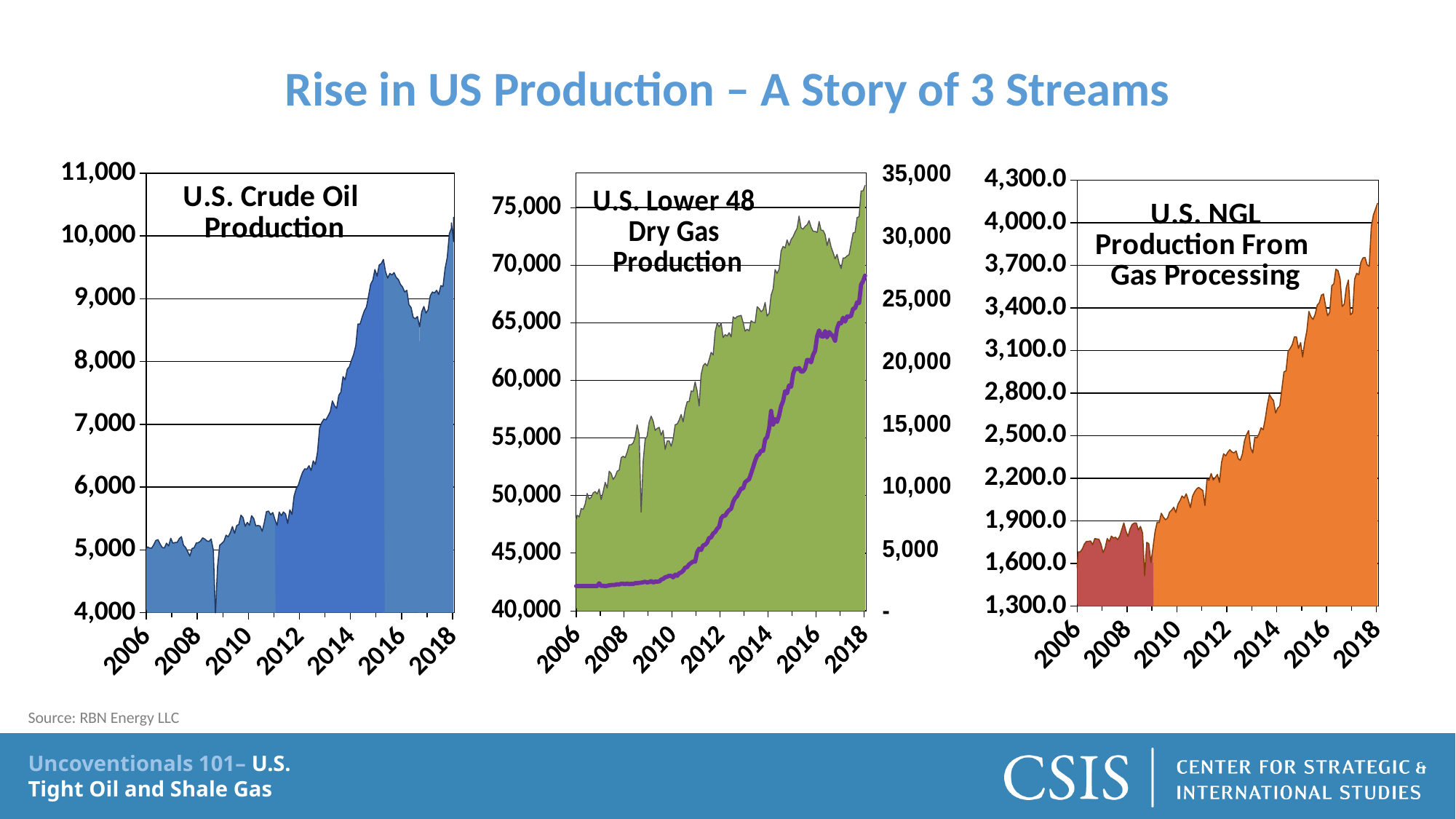
In the U.S. NGL Production From Gas Processing chart, is the value at the end of 2018 greater or less than 3,700.0? greater How many charts are shown on the slide? 3 In the U.S. Lower 48 Dry Gas Production chart, do the shaded area values rise or fall from 2006 to 2018? rise In the U.S. NGL Production From Gas Processing chart, is the value in 2006 greater or less than 1,900.0? less In the U.S. Lower 48 Dry Gas Production chart, is the shaded area value at the end of 2018 greater or less than 70,000 on the left axis? greater What source is cited for the charts on the slide? RBN Energy LLC In the U.S. NGL Production From Gas Processing chart, do values rise or fall from 2006 to 2018? rise In the U.S. Crude Oil Production chart, do values rise or fall from 2006 to 2018? rise What kind of chart is the U.S. Crude Oil Production chart? area chart